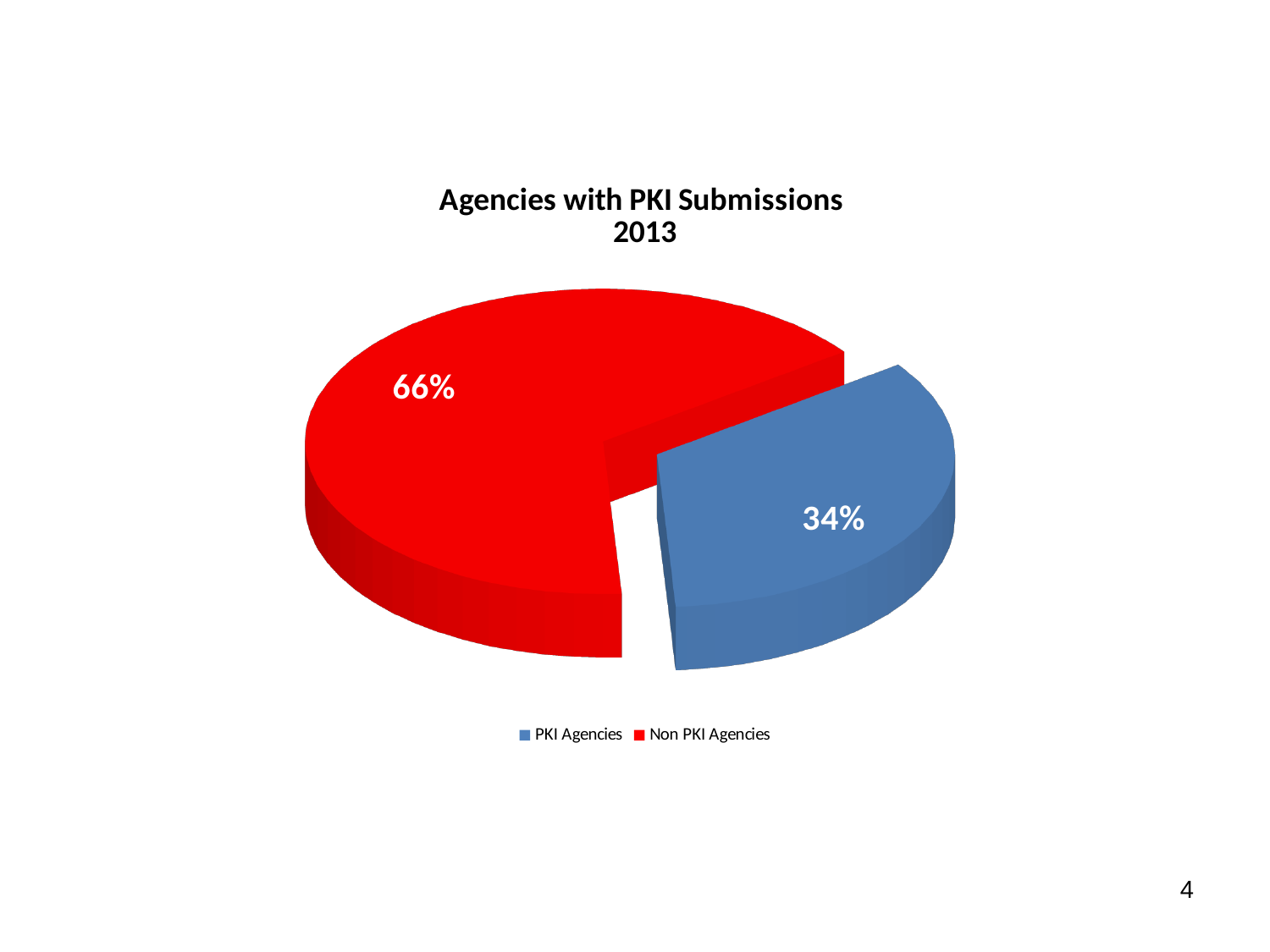
Which category has the largest slice of the pie? Non PKI Agencies How many entries does the legend list? 2 What is the title of the chart? Agencies with PKI Submissions 2013 Which is larger, the PKI Agencies slice or the Non PKI Agencies slice? Non PKI Agencies What colour is the PKI Agencies slice? Blue Which category has the smallest slice of the pie? PKI Agencies What kind of chart is shown on the slide? Pie chart What share of the pie is PKI Agencies? 34% What share of the pie is Non PKI Agencies? 66% How many slices does the pie chart have? 2 What is the difference in percentage points between Non PKI Agencies and PKI Agencies? 32